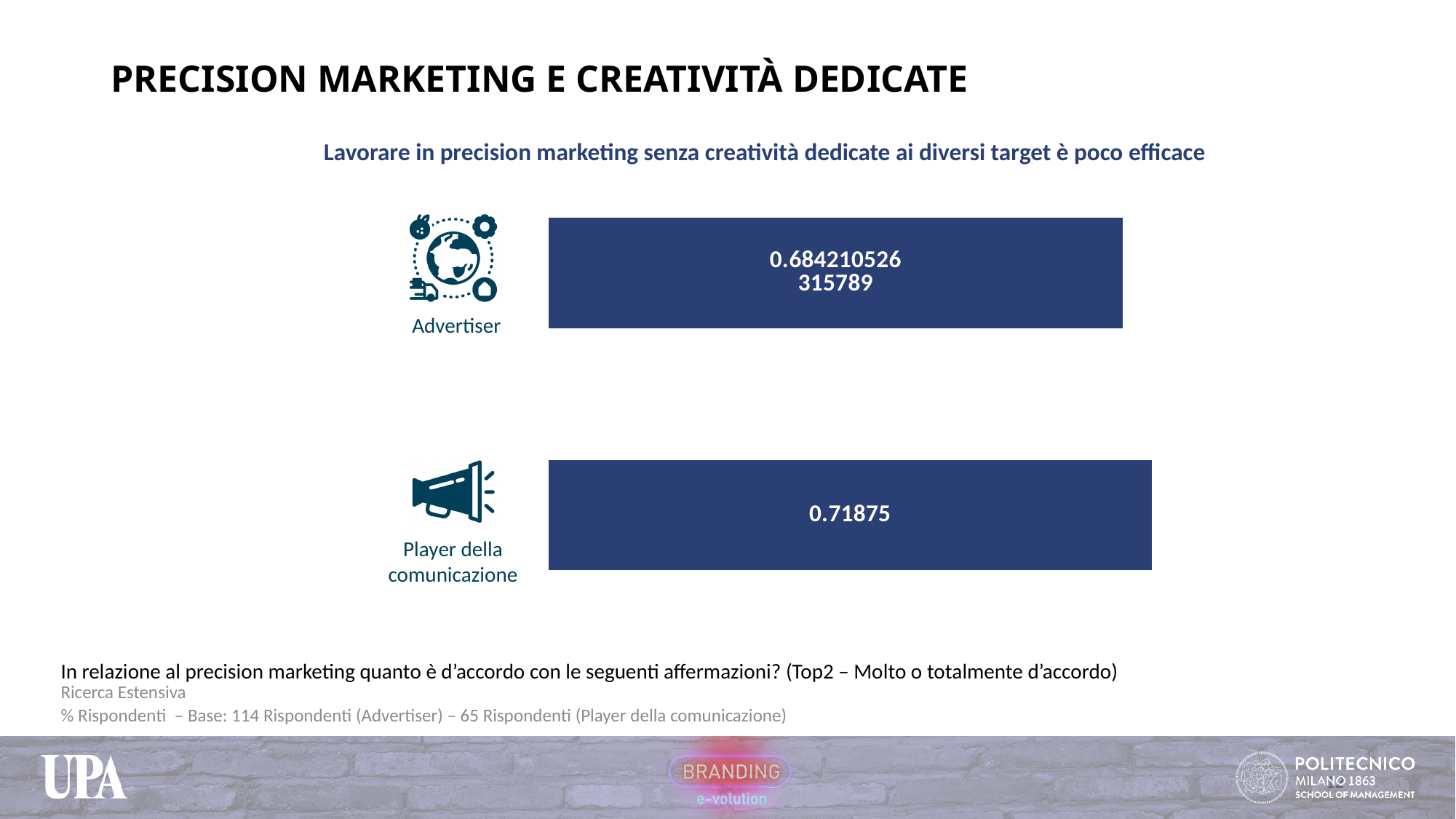
What colour are the bars in the chart? dark blue Which category has the lower value? Advertiser Which category has the higher value? Player della comunicazione Is the value for Advertiser larger or smaller than the value for Player della comunicazione? smaller How many categories are plotted in the chart? 2 What kind of chart is shown on the slide? bar chart What is the value shown for Player della comunicazione? 0.71875 Are the bars in the chart horizontal or vertical? horizontal What statement does the chart title say is poorly effective? Lavorare in precision marketing senza creatività dedicate ai diversi target è poco efficace What is the value shown for Advertiser? 0.684210526315789